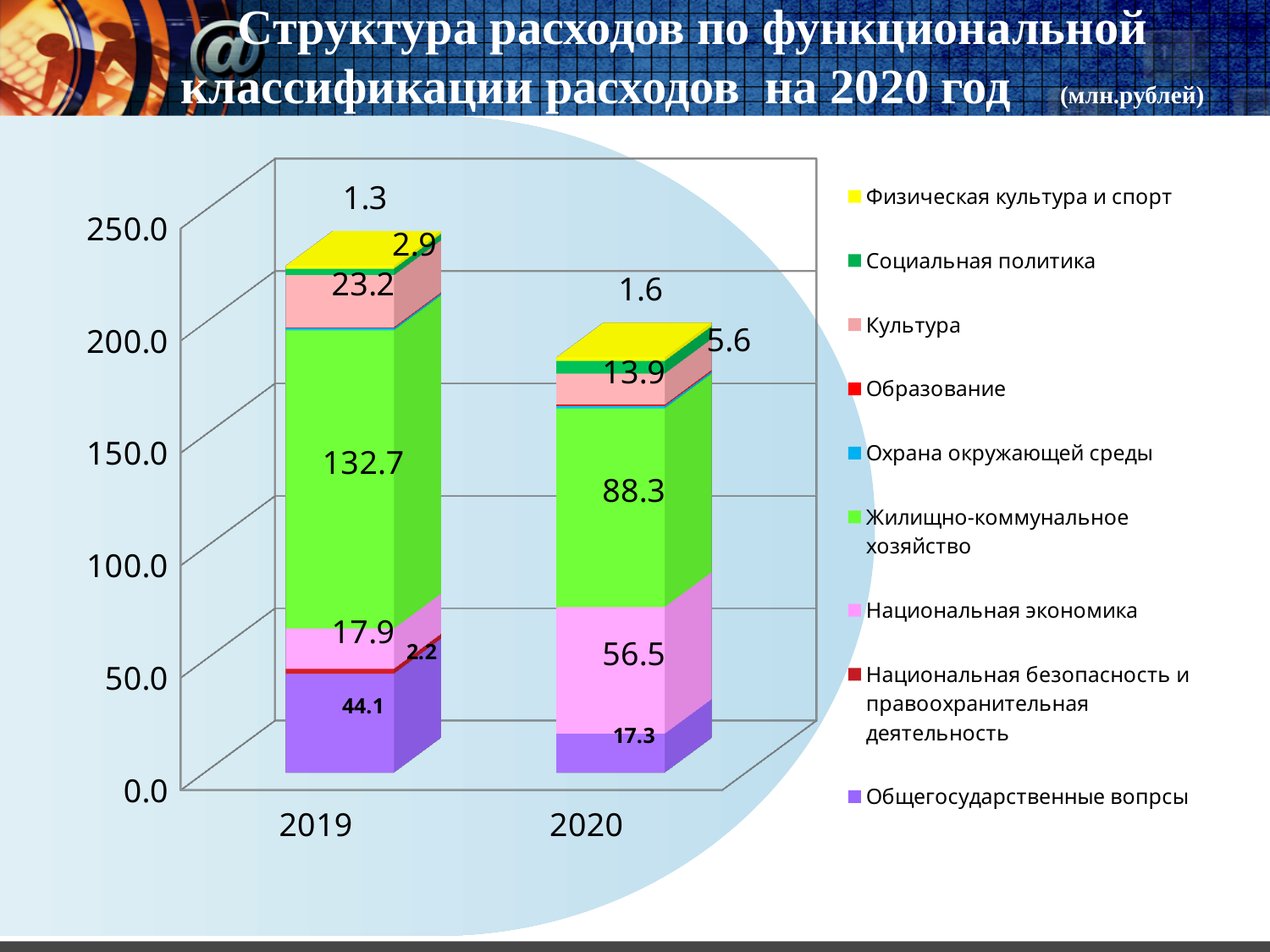
What is the value for Жилищно-коммунальное хозяйство in 2020? 88.3 What is the value for Жилищно-коммунальное хозяйство in 2019? 132.7 How many years (categories) are shown on the x axis? 2 Which year has the larger value for Национальная экономика, 2019 or 2020? 2020 What kind of chart is shown on the slide? Stacked bar chart What is the value for Культура in 2020? 13.9 Is the total height of the 2020 bar greater or less than 200.0? less How many series does the legend list? 9 By how much did Жилищно-коммунальное хозяйство decrease from 2019 to 2020? 44.4 What is the difference between Общегосударственные вопросы in 2019 and in 2020? 26.8 What is the value for Общегосударственные вопросы in 2019? 44.1 What is the value for Национальная экономика in 2020? 56.5